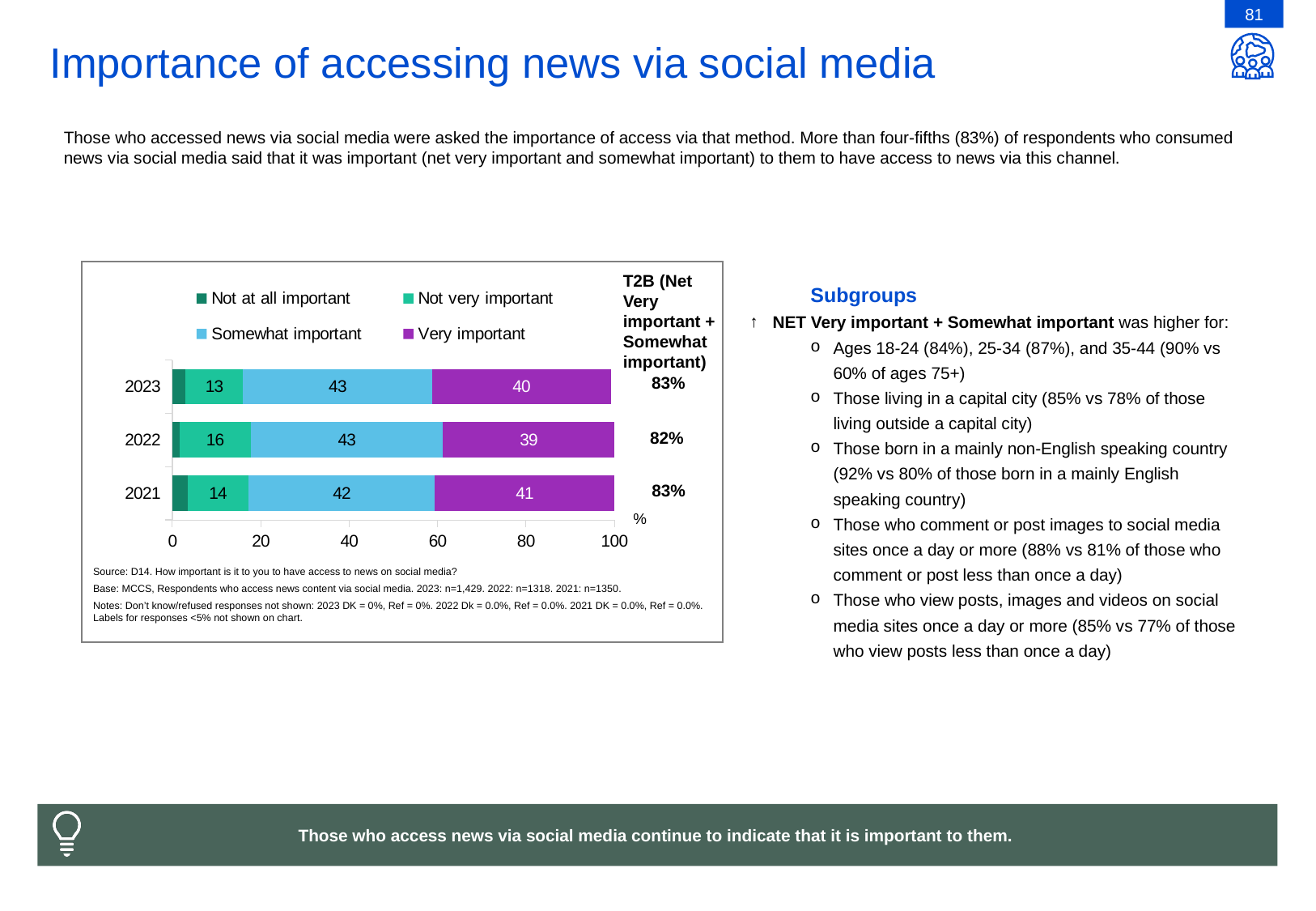
What is the value for Not very important in 2021? 14 What is the T2B (Net Very important + Somewhat important) figure shown for 2022? 82% Which legend entry is shown in purple? Very important Which year has the highest value for Very important? 2021 How many years are shown on the chart? 3 How many series does the legend list? 4 What kind of chart is shown on the slide? Stacked bar chart What is the value for Very important in 2022? 39 Which year has the lowest value for Not very important? 2023 What is the difference between the Very important values for 2021 and 2022? 2 Which is larger: the Not very important value for 2022 or for 2023? 2022 What is the value for Somewhat important in 2023? 43